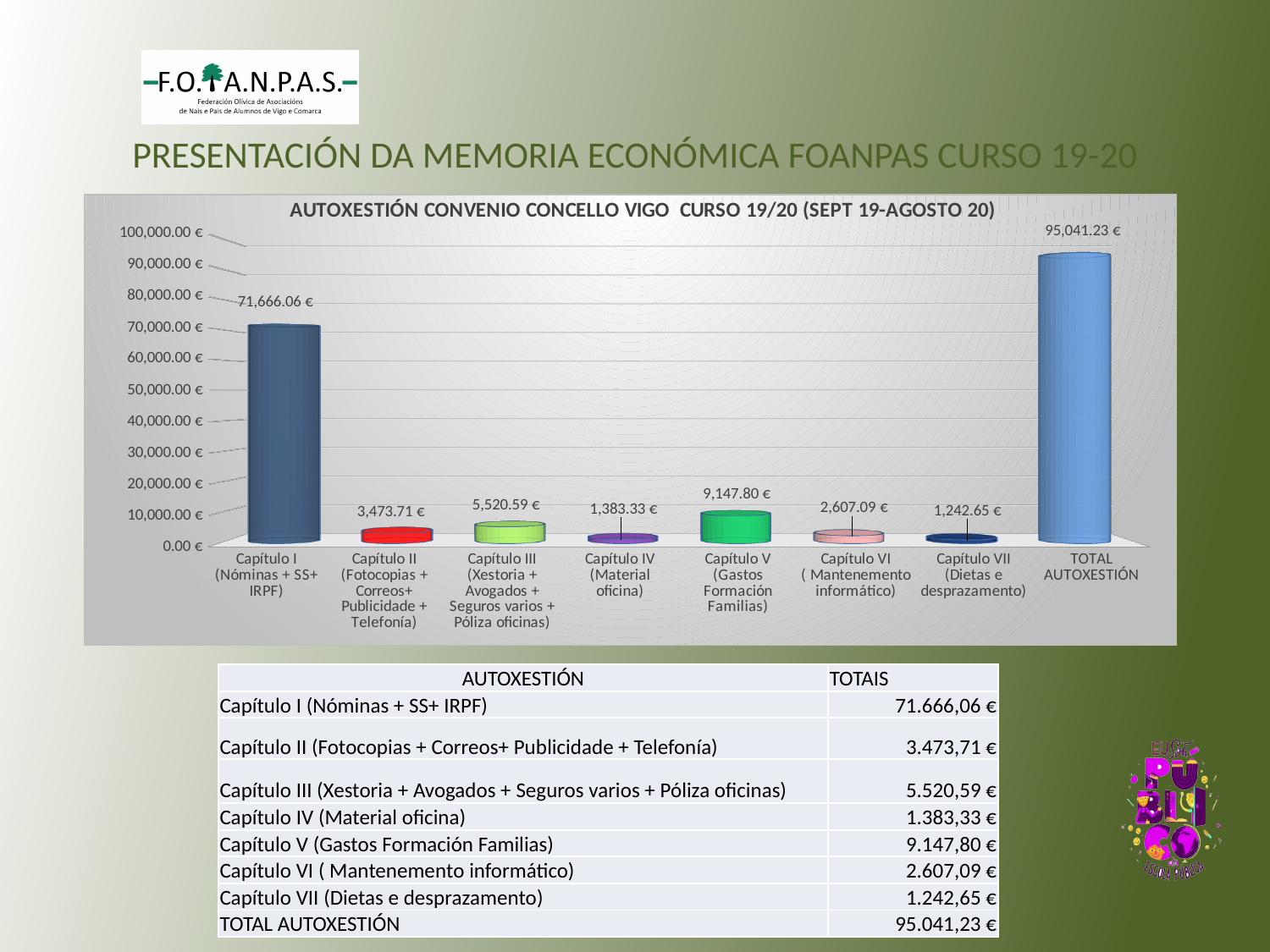
How many categories are plotted in the chart? 8 Which category has the lowest value in the chart? Capítulo VII (Dietas e desprazamento) What is the value for Capítulo V (Gastos Formación Familias)? 9,147.80 € Which is larger, the value for Capítulo III or the value for Capítulo II? Capítulo III Which category has the highest value in the chart? TOTAL AUTOXESTIÓN What is the value shown for TOTAL AUTOXESTIÓN? 95,041.23 € What is the difference between the values for Capítulo V and Capítulo II? 5,674.09 € What is the value for Capítulo VI (Mantenemento informático)? 2,607.09 € What is the difference between TOTAL AUTOXESTIÓN and Capítulo I? 23,375.17 € What kind of chart is shown on the slide? Bar chart What is the value for Capítulo I (Nóminas + SS+ IRPF)? 71,666.06 € Is the value for Capítulo I greater or less than 60,000.00 €? greater